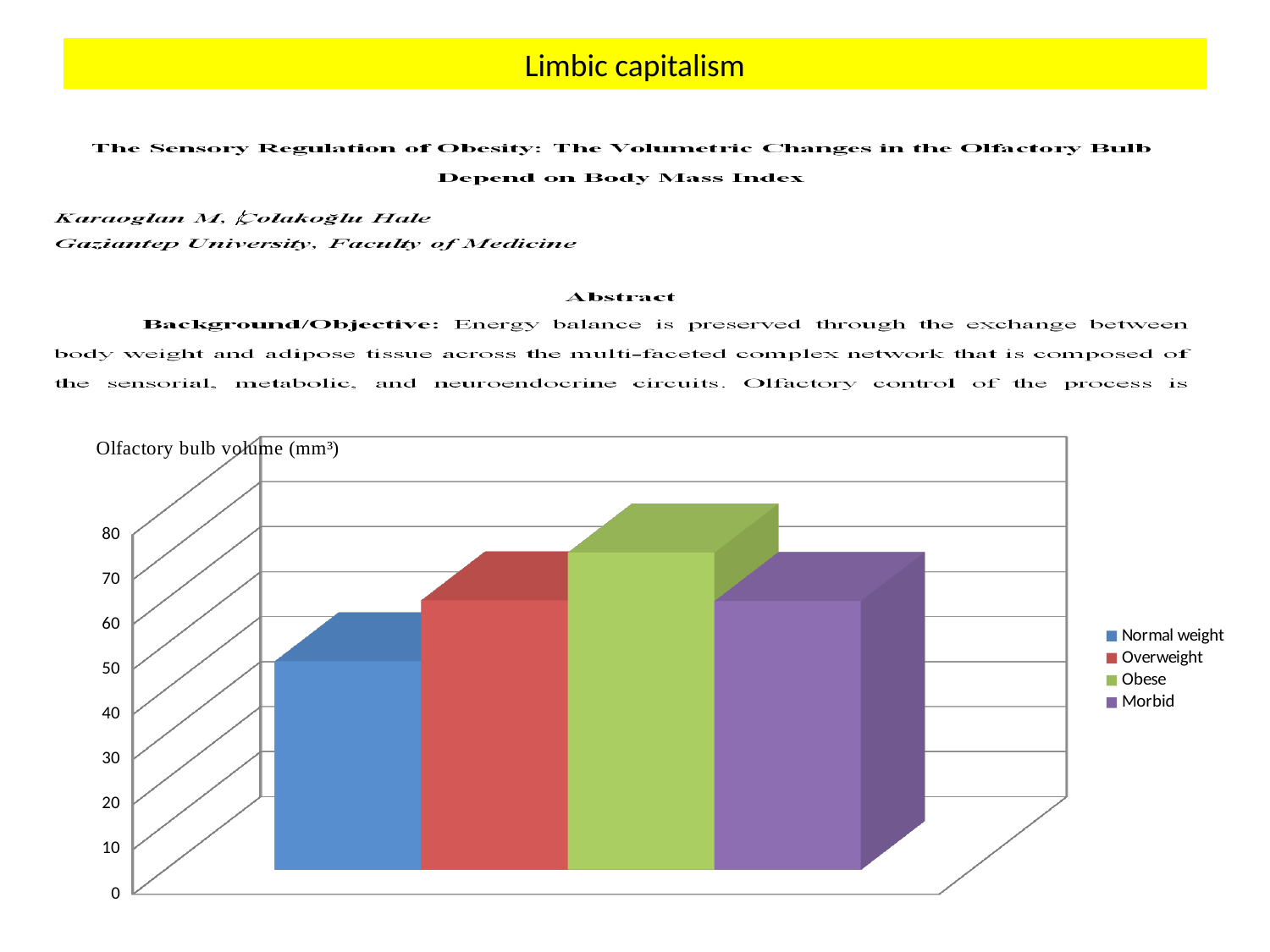
What kind of chart is shown on the slide? bar chart Is the value for Normal weight greater or less than 60? less How many entries does the chart legend list? 4 Is the value for Normal weight greater or less than 40? greater Which group has the lowest olfactory bulb volume in the chart? Normal weight What is the title of the chart? Olfactory bulb volume (mm³) How many bars are plotted in the chart? 4 Which group has the highest olfactory bulb volume in the chart? Obese Which is larger, the value for Obese or the value for Normal weight? Obese